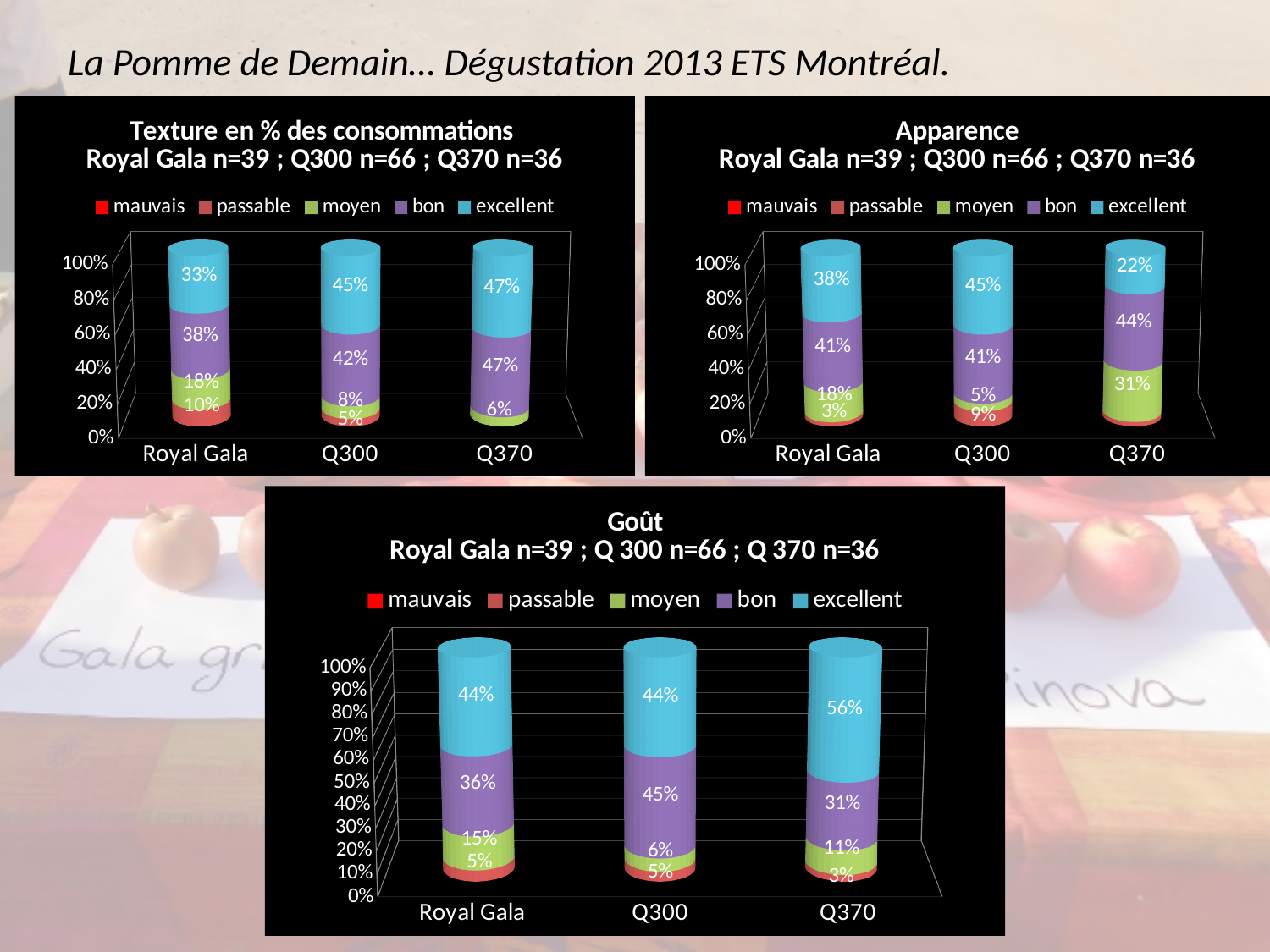
In the Goût chart, what is the 'excellent' percentage for Q370? 56% How many categories are shown on the x axis of the Texture chart? 3 In the Apparence chart, which category has the lowest 'excellent' percentage? Q370 What kind of chart is the Apparence chart? Stacked bar chart How many series does the legend of the Goût chart list? 5 In the Texture chart, which category has the highest 'excellent' percentage? Q370 In the Goût chart, which is larger: the 'bon' percentage for Q300 or for Q370? Q300 In the Apparence chart, what is the difference between the 'moyen' percentages for Q370 and Q300? 26% In the Texture chart, what is the 'moyen' percentage for Royal Gala? 18% In the Texture chart, what is the 'excellent' percentage for Q370? 47% In the Goût chart, what is the difference between the 'excellent' percentages for Q370 and Royal Gala? 12% In the Apparence chart, what is the 'bon' percentage for Q370? 44%